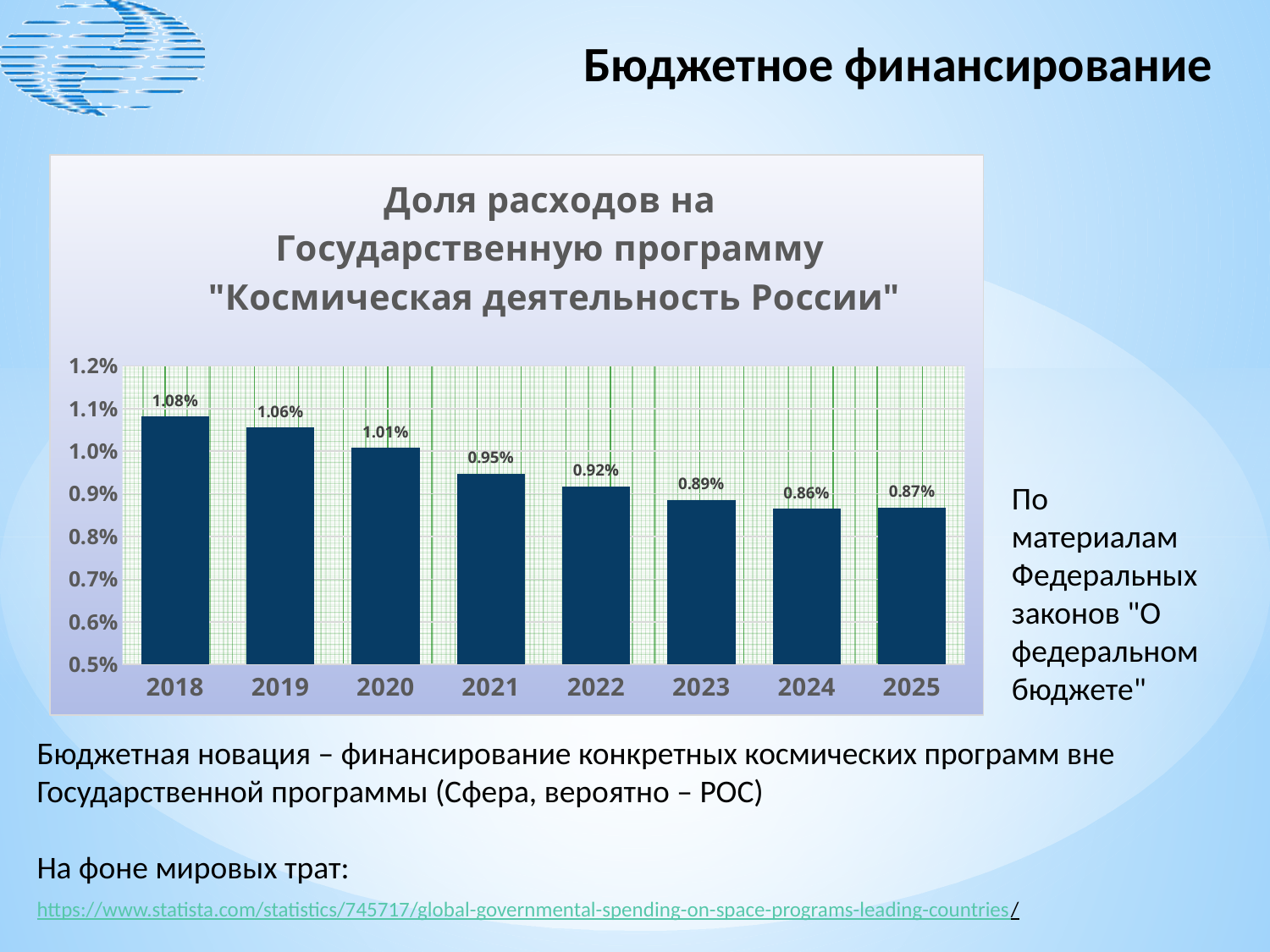
What is the title of the chart? Доля расходов на Государственную программу "Космическая деятельность России" Is the value for 2023 greater or less than 1.0%? less Which year has the lowest value? 2024 What is the value for 2018? 1.08% Which year has the highest value? 2018 What is the value for 2021? 0.95% Which is larger, the value for 2020 or the value for 2022? 2020 How many years are shown on the x axis? 8 What kind of chart is this? bar chart What is the value for 2025? 0.87% Do the values generally rise or fall from 2018 to 2024? fall What is the difference between the values for 2018 and 2025? 0.21%